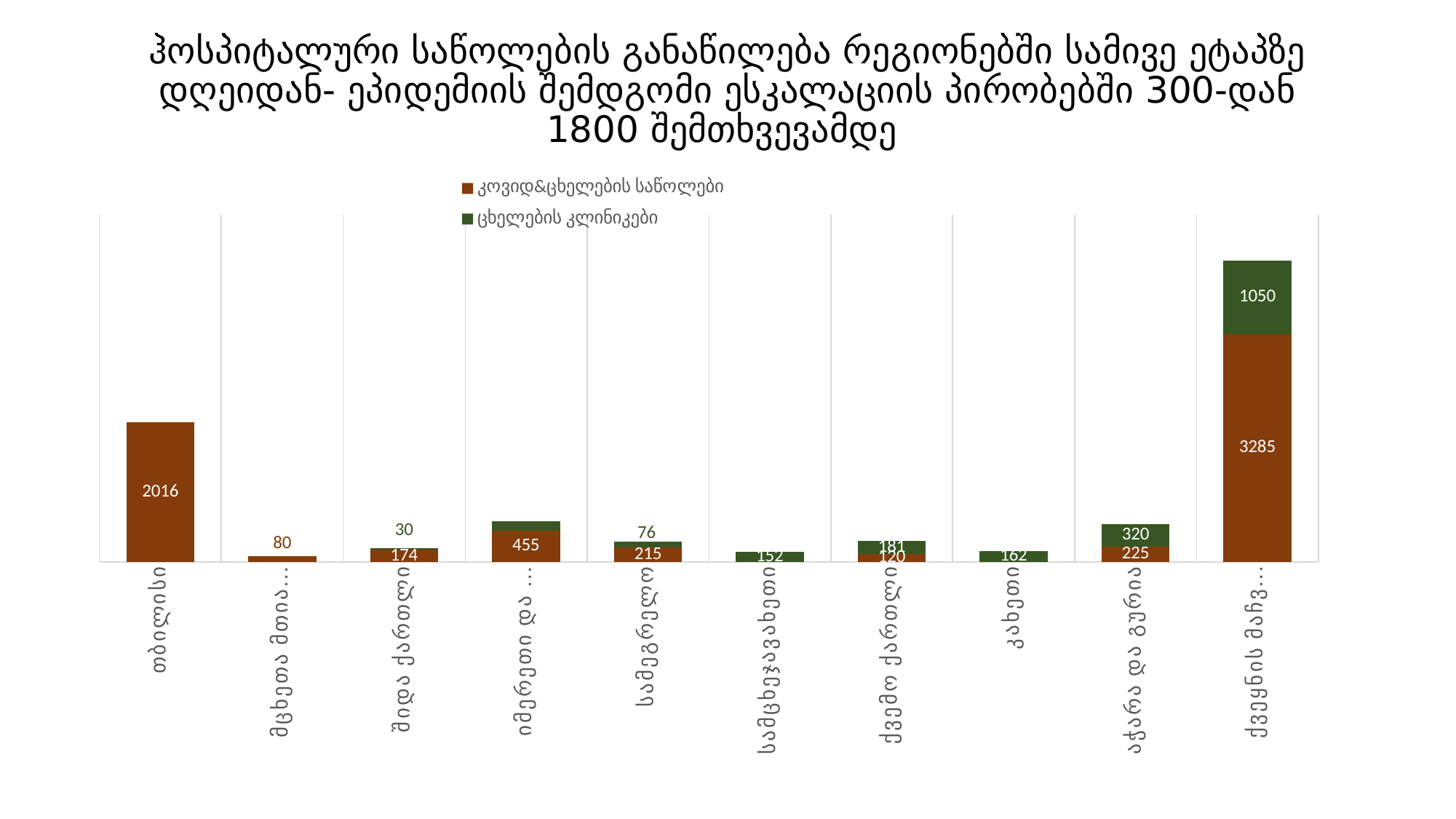
For შიდა ქართლი, what is the difference between კოვიდ&ცხელების საწოლები and ცხელების კლინიკები? 144 What is the total of the stacked bar for ქვემო ქართლი? 301 What is the value of ცხელების კლინიკები for ქვემო ქართლი? 181 How many categories are shown on the x axis? 10 What is the value shown for კახეთი? 162 What kind of chart is shown on the slide? bar chart How many series does the legend list? 2 What is the value of ცხელების კლინიკები for აჭარა და გურია? 320 What is the value of კოვიდ&ცხელების საწოლები for თბილისი? 2016 Which has a larger value for კოვიდ&ცხელების საწოლები, თბილისი or სამეგრელო? თბილისი What is the value of კოვიდ&ცხელების საწოლები for სამეგრელო? 215 What is the total of the stacked bar for აჭარა და გურია? 545